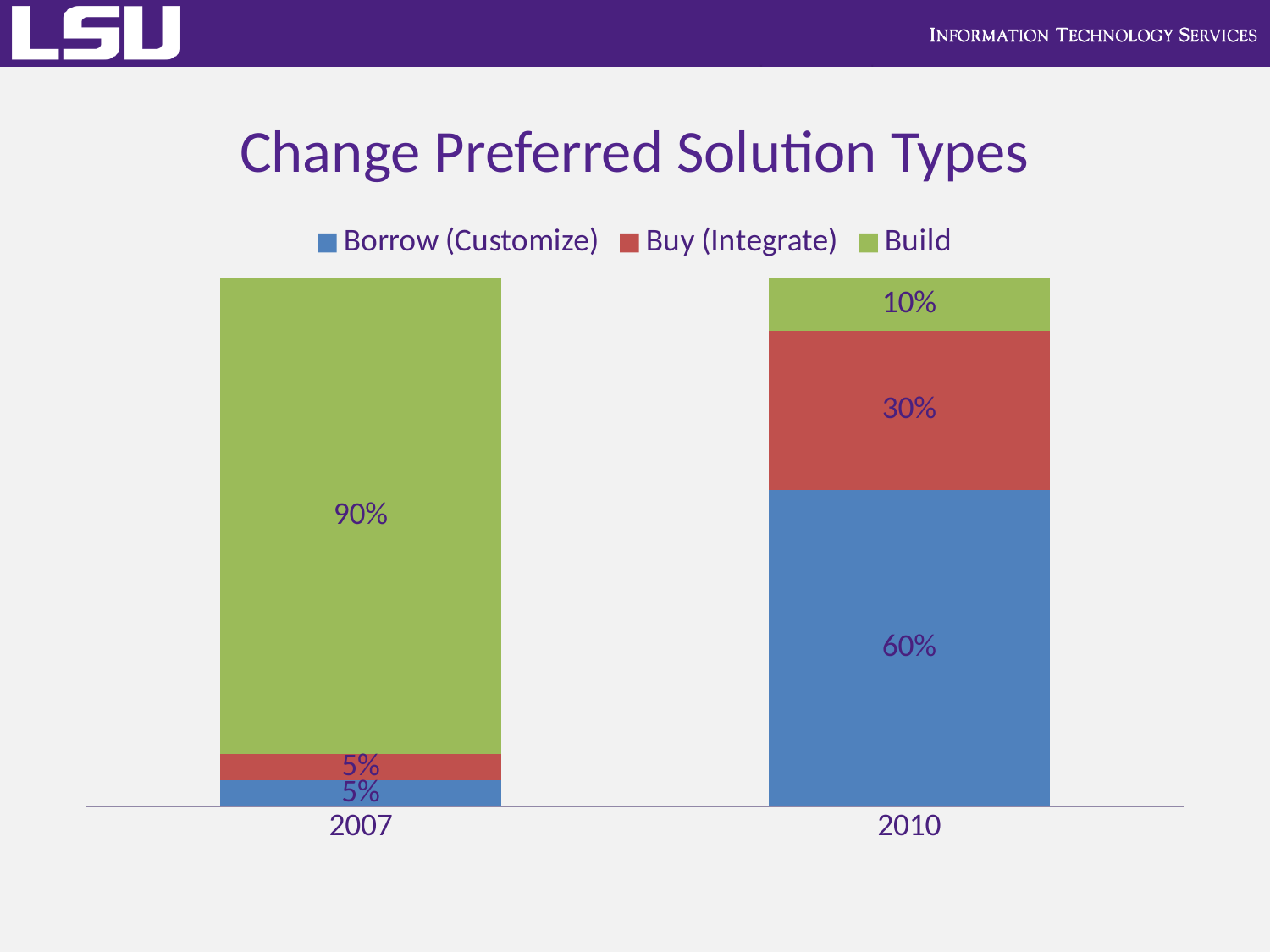
How many series does the legend list? 3 Which series has the largest value in 2007? Build Which is larger in 2010, Borrow (Customize) or Buy (Integrate)? Borrow (Customize) How many categories are shown on the x axis? 2 What is the value for Buy (Integrate) in 2010? 30% Which series has the smallest value in 2010? Build What is the value for Borrow (Customize) in 2007? 5% What is the value for Build in 2010? 10% What is the value for Build in 2007? 90% What kind of chart is shown on the slide? Stacked bar chart What is the difference between the Build value in 2007 and the Build value in 2010? 80% What is the value for Borrow (Customize) in 2010? 60%